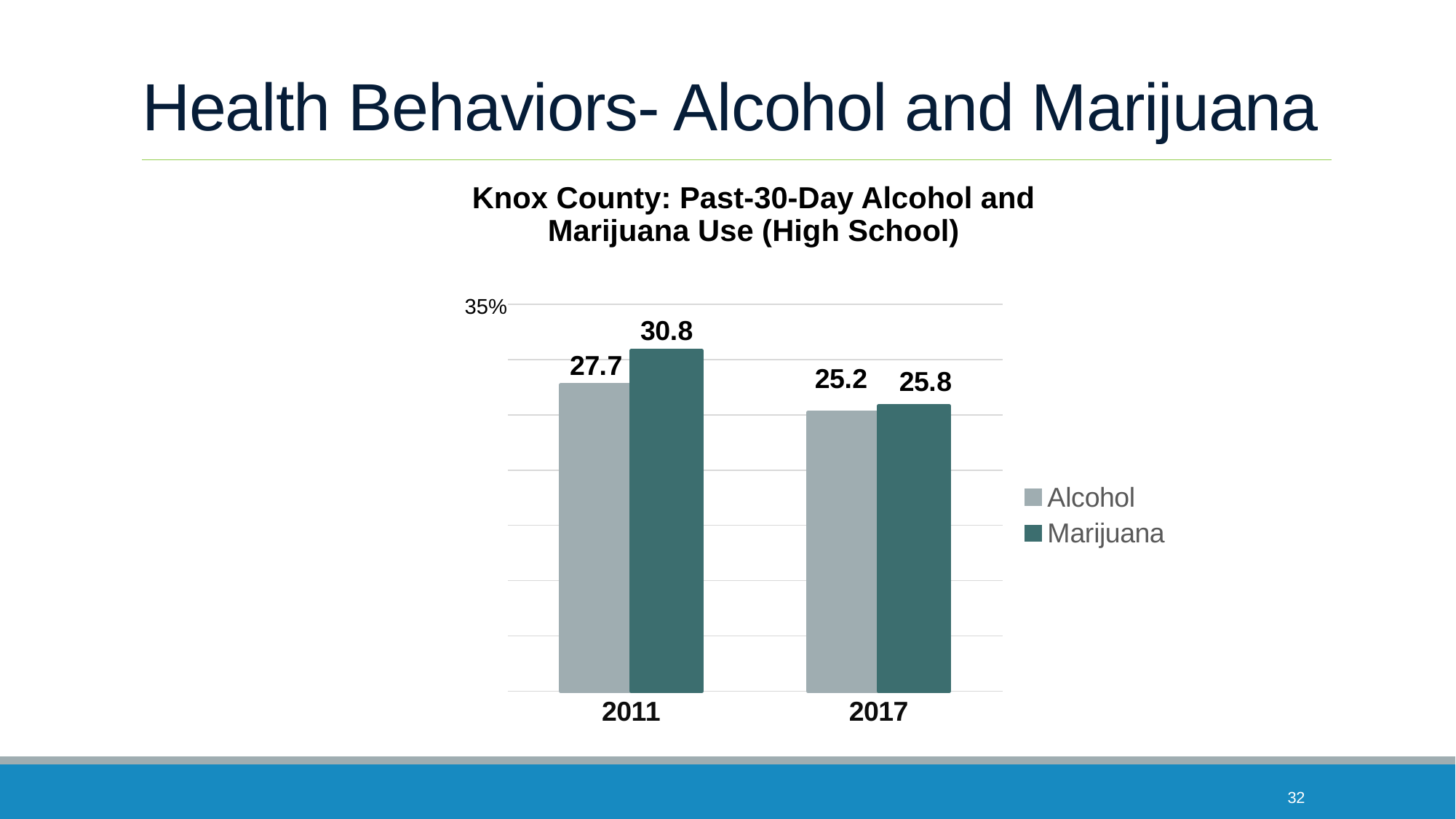
What kind of chart is shown on the slide? Bar chart By how much did the Alcohol value change from 2011 to 2017? 2.5 What is the Marijuana value for 2017? 25.8 How many series does the legend list? 2 What is the Alcohol value for 2017? 25.2 Which is larger in 2011, the Alcohol value or the Marijuana value? Marijuana Do the Marijuana values rise or fall from 2011 to 2017? Fall How many years are shown on the x axis? 2 What is the Alcohol value for 2011? 27.7 Which year has the lowest Alcohol value? 2017 Which year has the highest Marijuana value? 2011 What is the difference between the Marijuana and Alcohol values in 2011? 3.1